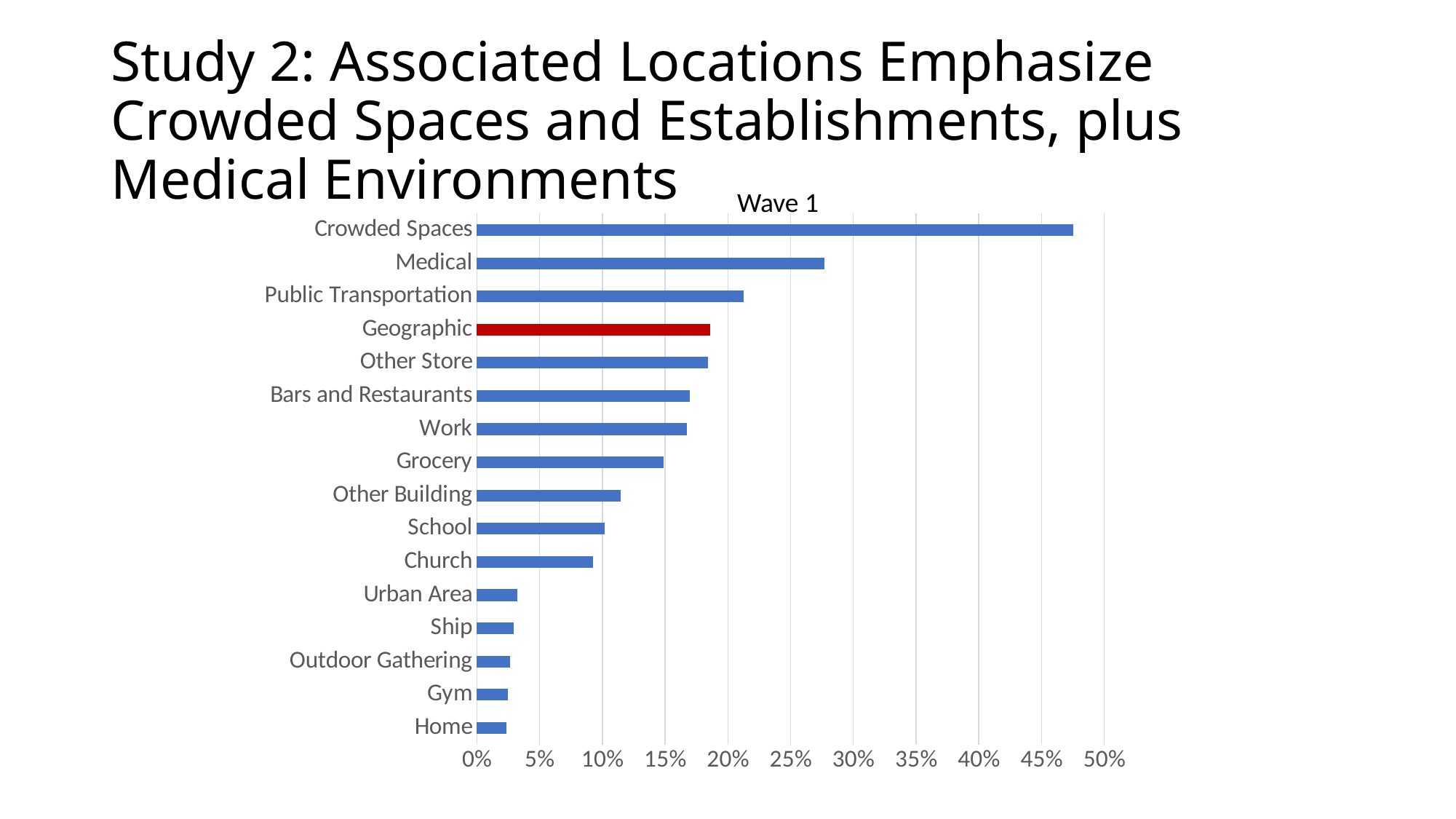
How many categories are plotted in the chart? 16 Is the value for Public Transportation greater or less than 20%? greater Which category's bar is coloured red rather than blue? Geographic Which has a larger value, Medical or Public Transportation? Medical Is the value for Crowded Spaces greater or less than 45%? greater What kind of chart is shown on the slide? bar chart Is the value for Medical greater or less than 25%? greater What is the title of the chart? Wave 1 Which has a larger value, Grocery or School? Grocery Which category has the highest value in the chart? Crowded Spaces